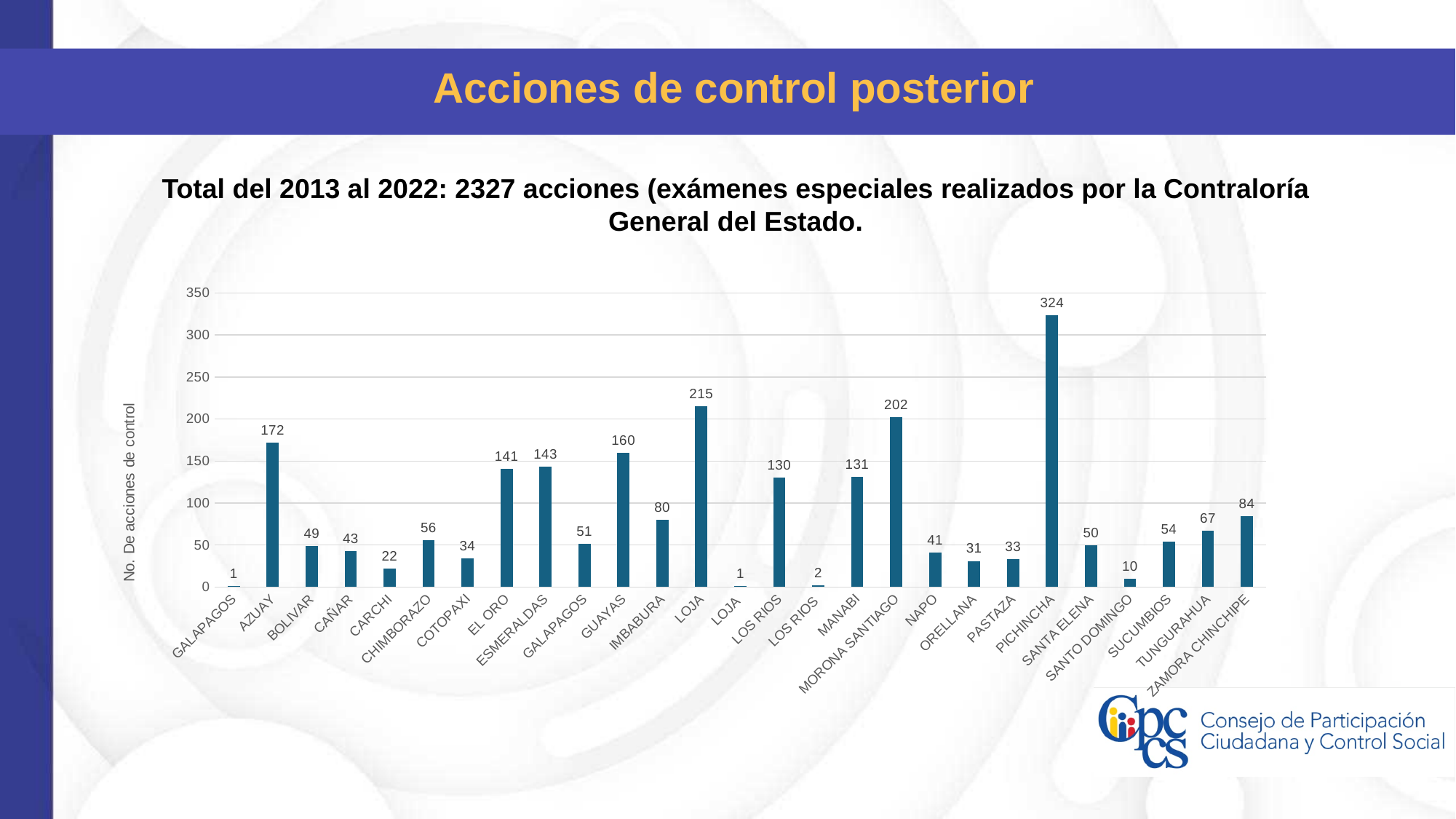
Which is larger, the value for GUAYAS or the value for ESMERALDAS? GUAYAS What is the value for SANTO DOMINGO? 10 Which category has the highest value? PICHINCHA What is the difference between the values for PICHINCHA and MORONA SANTIAGO? 122 Is the value for IMBABURA greater or less than 100? less What is the lowest value shown on the chart? 1 What kind of chart is shown on the slide? bar chart What is the value for PICHINCHA? 324 What is the label of the vertical axis? No. De acciones de control How many bars are plotted on the chart? 27 What is the value for AZUAY? 172 What is the value for MORONA SANTIAGO? 202